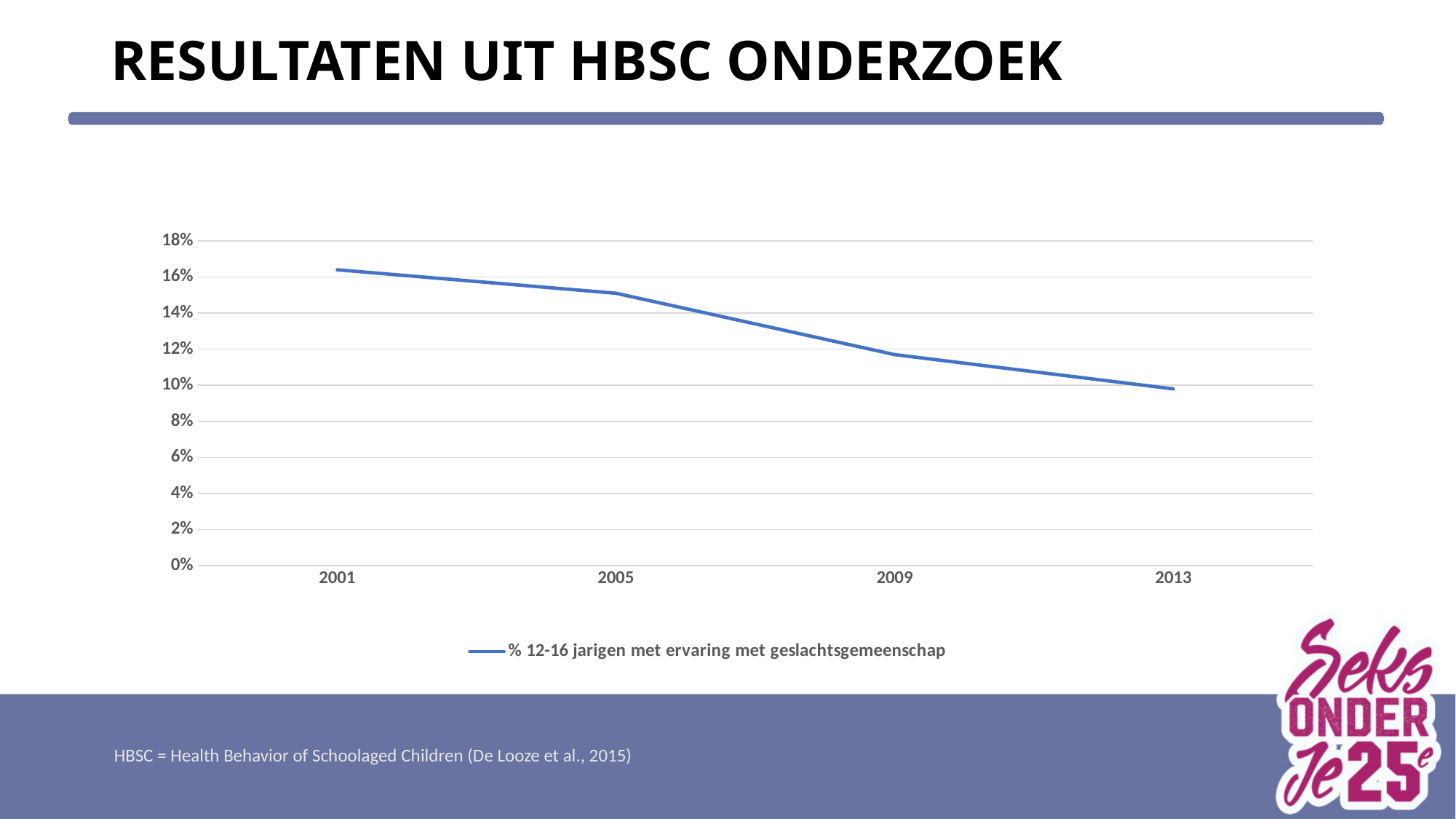
Is the value for 2005 greater or less than 14%? greater What is the series name shown in the chart legend? % 12-16 jarigen met ervaring met geslachtsgemeenschap What kind of chart is shown on the slide? line chart Which year has the larger value, 2005 or 2009? 2005 Which year has the lowest value for % 12-16 jarigen met ervaring met geslachtsgemeenschap? 2013 How many years are plotted on the x axis of the chart? 4 Is the value for 2009 greater or less than 14%? less How many series does the chart legend list? 1 Which year has the highest value for % 12-16 jarigen met ervaring met geslachtsgemeenschap? 2001 Is the value for 2013 greater or less than 12%? less Do the values rise or fall from 2001 to 2013? fall